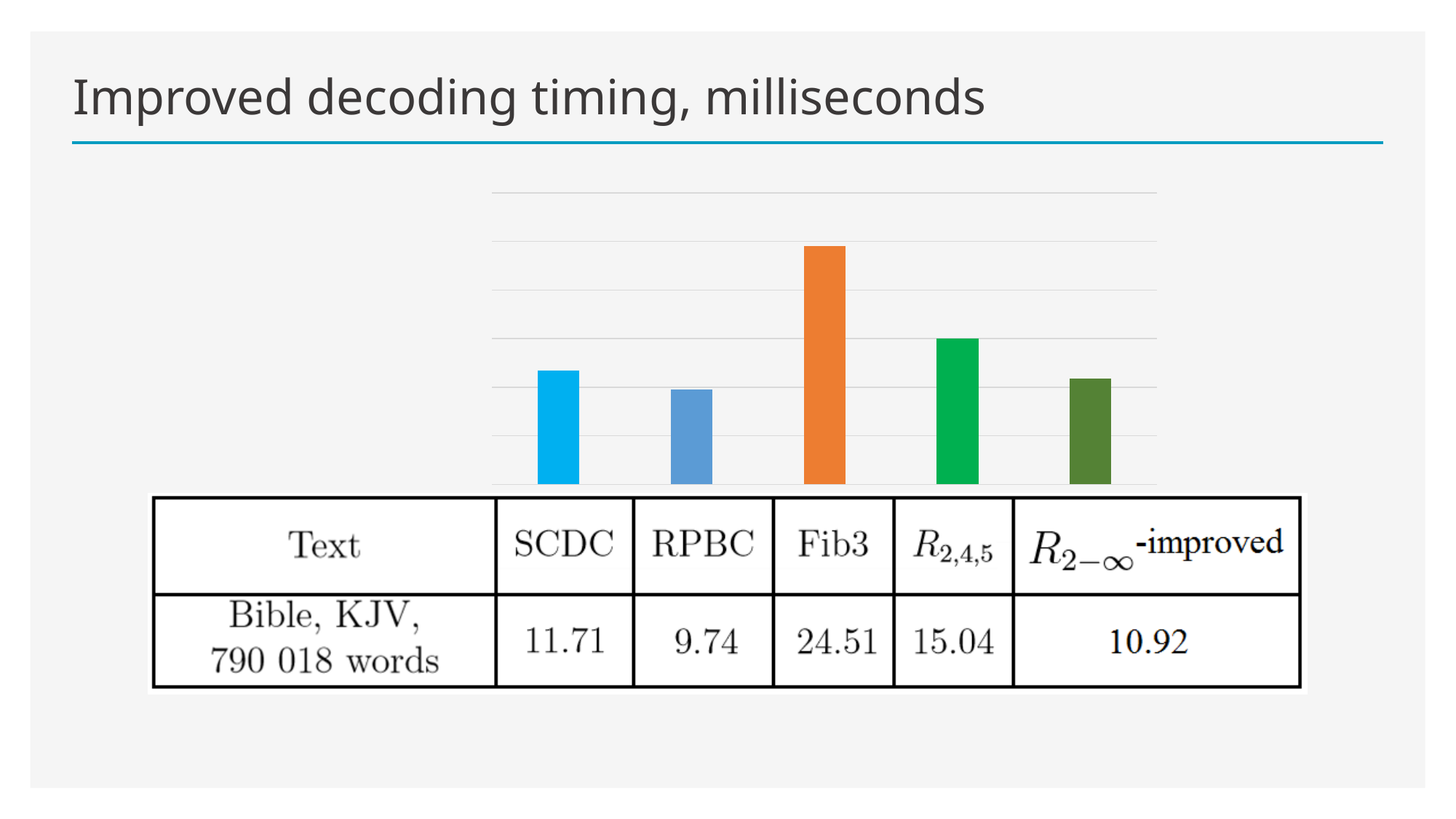
What is the decoding time for R2-∞-improved? 10.92 Which method has the highest decoding time? Fib3 Which method has the lowest decoding time? RPBC What kind of chart is shown on the slide? Bar chart How many bars are shown in the chart? 5 What is the difference in decoding time between Fib3 and RPBC? 14.77 What is the decoding time for RPBC? 9.74 What is the decoding time for R2,4,5? 15.04 What is the decoding time for SCDC? 11.71 What is the title of the slide? Improved decoding timing, milliseconds Which has a larger decoding time, SCDC or R2-∞-improved? SCDC What is the decoding time for Fib3? 24.51